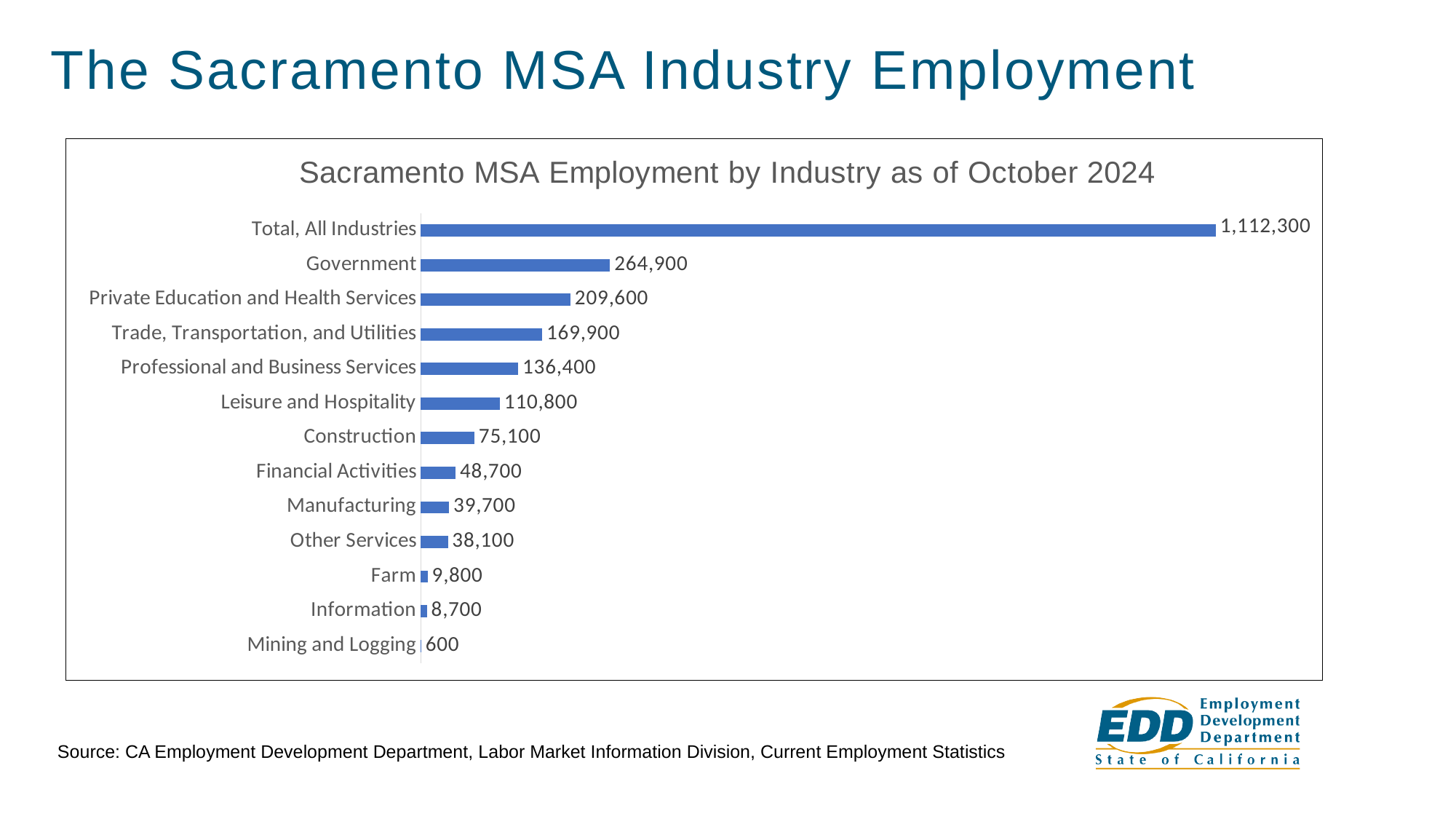
What type of chart is shown on the slide? Bar chart What is the value shown for Total, All Industries? 1,112,300 How many bars (categories) are shown in the chart? 13 Which industry has the lowest employment? Mining and Logging What is the employment value for Government? 264,900 What is the difference between Government and Private Education and Health Services employment? 55,300 Which has higher employment, Manufacturing or Other Services? Manufacturing What is the difference between Construction and Financial Activities employment? 26,400 Excluding the Total, All Industries bar, which industry has the highest employment? Government What is the title of the chart? Sacramento MSA Employment by Industry as of October 2024 What is the employment value for Leisure and Hospitality? 110,800 What is the employment value for Mining and Logging? 600